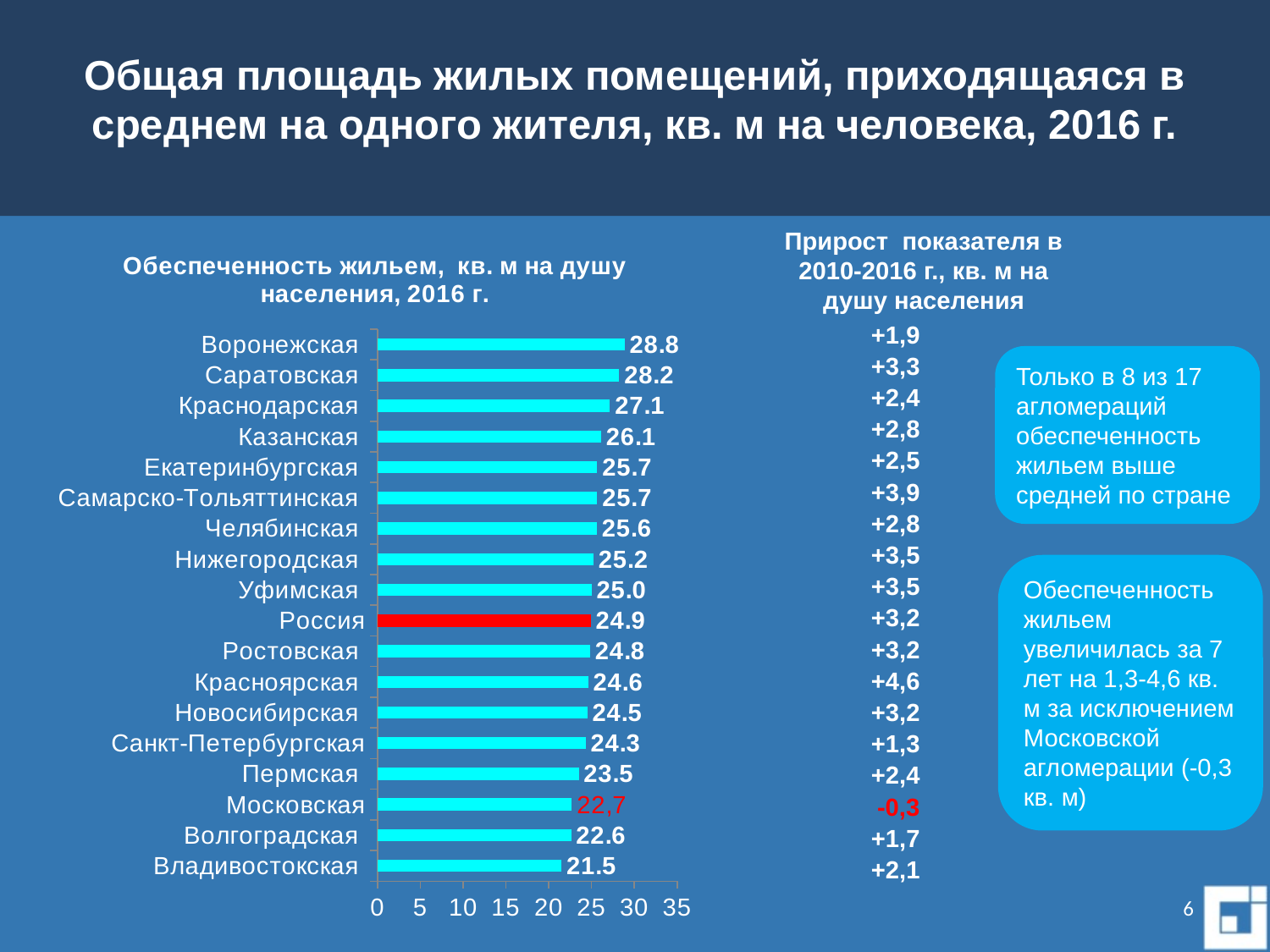
Which is larger, the value for Казанская or the value for Пермская? Казанская What is the difference between the values for Воронежская and Владивостокская? 7.3 What type of chart is shown on the slide? bar chart How many bars (categories) are shown in the chart? 18 What is the value for Россия in the chart? 24.9 What is the difference between the values for Саратовская and Россия? 3.3 What is the value for Воронежская in the chart «Обеспеченность жильем, кв. м на душу населения, 2016 г.»? 28.8 Which category has the lowest value in the chart? Владивостокская Is the value for Краснодарская greater or less than 25? greater Which bar in the chart is coloured red instead of cyan? Россия What is the value for Московская in the chart? 22,7 Which category has the highest value in the chart? Воронежская